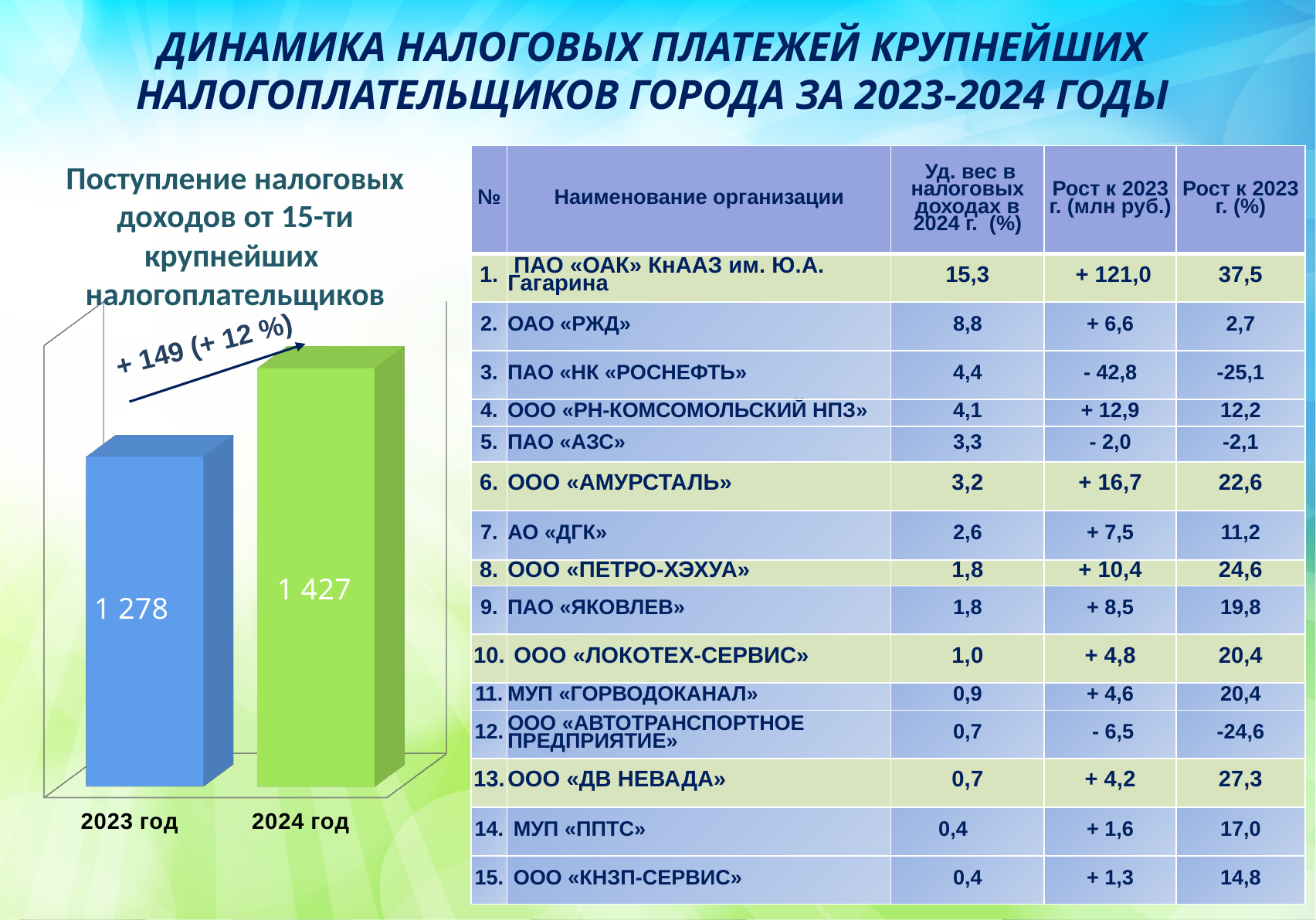
What is the value shown for 2023 год on the bar chart? 1 278 Which year has the higher bar on the chart? 2024 год Which year has the lower bar on the chart? 2023 год Do the values on the bar chart rise or fall from 2023 год to 2024 год? rise What is the value shown for 2024 год on the bar chart? 1 427 What type of chart is shown on the left of the slide? bar chart Is the value for 2024 год larger or smaller than the value for 2023 год? larger What colour is the bar for 2024 год? green How many bars are plotted on the chart? 2 By how much does the 2024 год value exceed the 2023 год value on the bar chart? 149 What percentage growth is written on the arrow above the bars? + 12 %